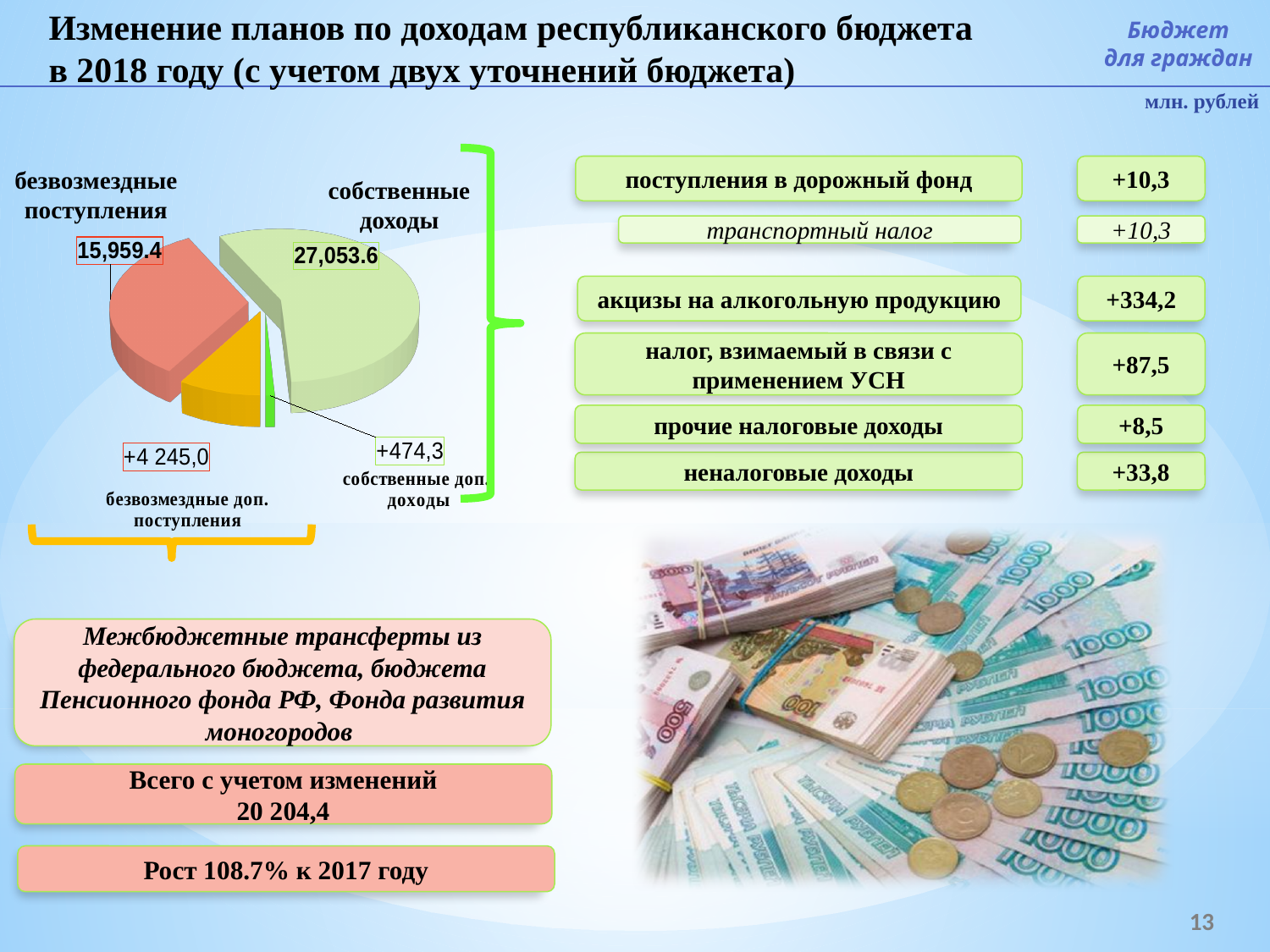
Which is larger in the pie chart: "безвозмездные доп. поступления" or "собственные доп. доходы"? безвозмездные доп. поступления What value is shown for the "собственные доходы" slice of the pie chart? 27,053.6 What value is labelled for the "собственные доп. доходы" slice of the pie chart? +474,3 In what units are the values on the slide expressed? млн. рублей Which slice of the pie chart has the largest value? собственные доходы What colour is the "собственные доходы" slice of the pie chart? green What value is shown for the "безвозмездные поступления" slice of the pie chart? 15,959.4 Which slice of the pie chart has the smallest value? собственные доп. доходы Which is larger in the pie chart: "собственные доходы" or "безвозмездные поступления"? собственные доходы How many slices does the pie chart have? 4 What kind of chart is shown on the slide? pie chart What value is labelled for the "безвозмездные доп. поступления" slice of the pie chart? +4 245,0